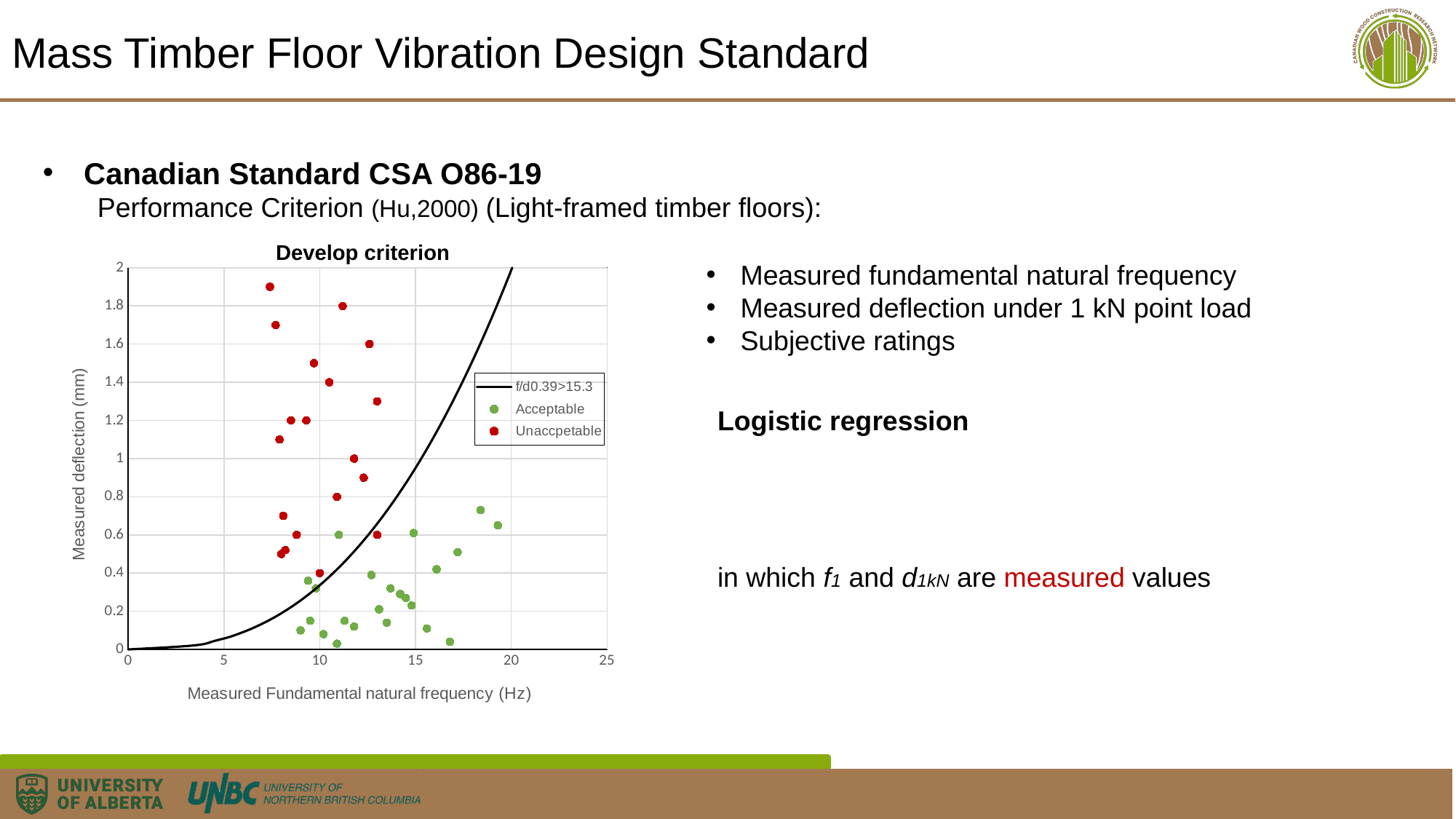
How many entries does the chart's legend list? 3 What kind of chart is shown on the slide? Scatter chart What is the title of the chart? Develop criterion What is the label of the x axis of the chart? Measured Fundamental natural frequency (Hz) What is the maximum value shown on the y axis of the chart? 2 Is the measured deflection of the highest Unaccpetable point greater or less than 1.8? greater Which series contains the point with the highest measured deflection? Unaccpetable Is the measured deflection of the highest Acceptable point greater or less than 1? less